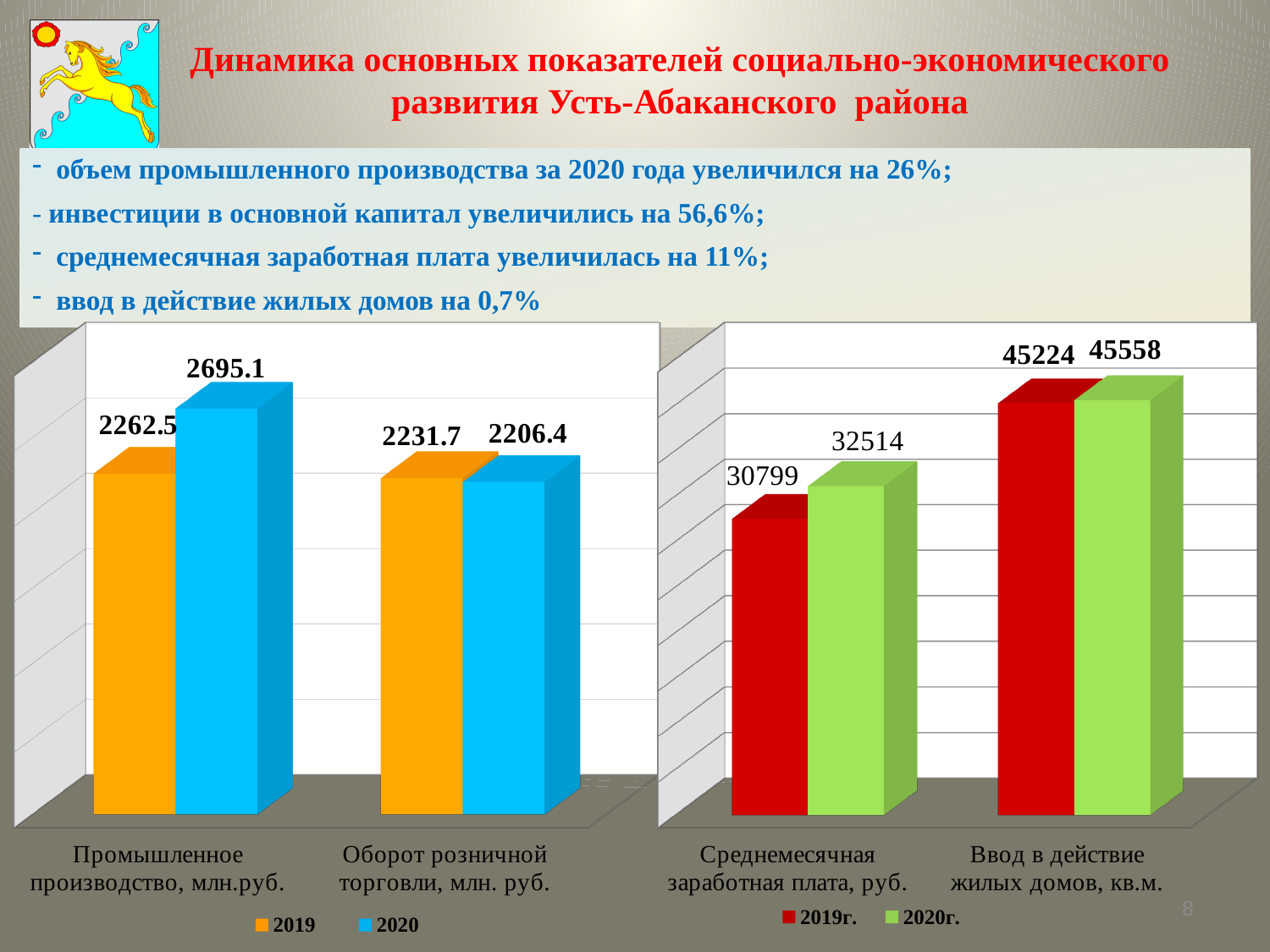
In the left chart, what is the 2019 value for Оборот розничной торговли, млн. руб.? 2231.7 In the right chart, what is the 2019г. value for Среднемесячная заработная плата, руб.? 30799 In the right chart, which colour represents the 2019г. series? Red In the left chart, which is larger for Оборот розничной торговли, млн. руб.: the 2019 value or the 2020 value? 2019 In the left chart, what is the difference between the 2020 and 2019 values for Промышленное производство, млн.руб.? 432.6 In the right chart, which bar is the highest? Ввод в действие жилых домов, кв.м., 2020г. In the left chart, what is the 2020 value for Промышленное производство, млн.руб.? 2695.1 What kind of chart is the left chart? Bar chart In the left chart, how many series does the legend list? 2 In the right chart, how many categories are shown on the x axis? 2 In the right chart, what is the 2020г. value for Ввод в действие жилых домов, кв.м.? 45558 In the right chart, what is the difference between the 2020г. and 2019г. values for Среднемесячная заработная плата, руб.? 1715